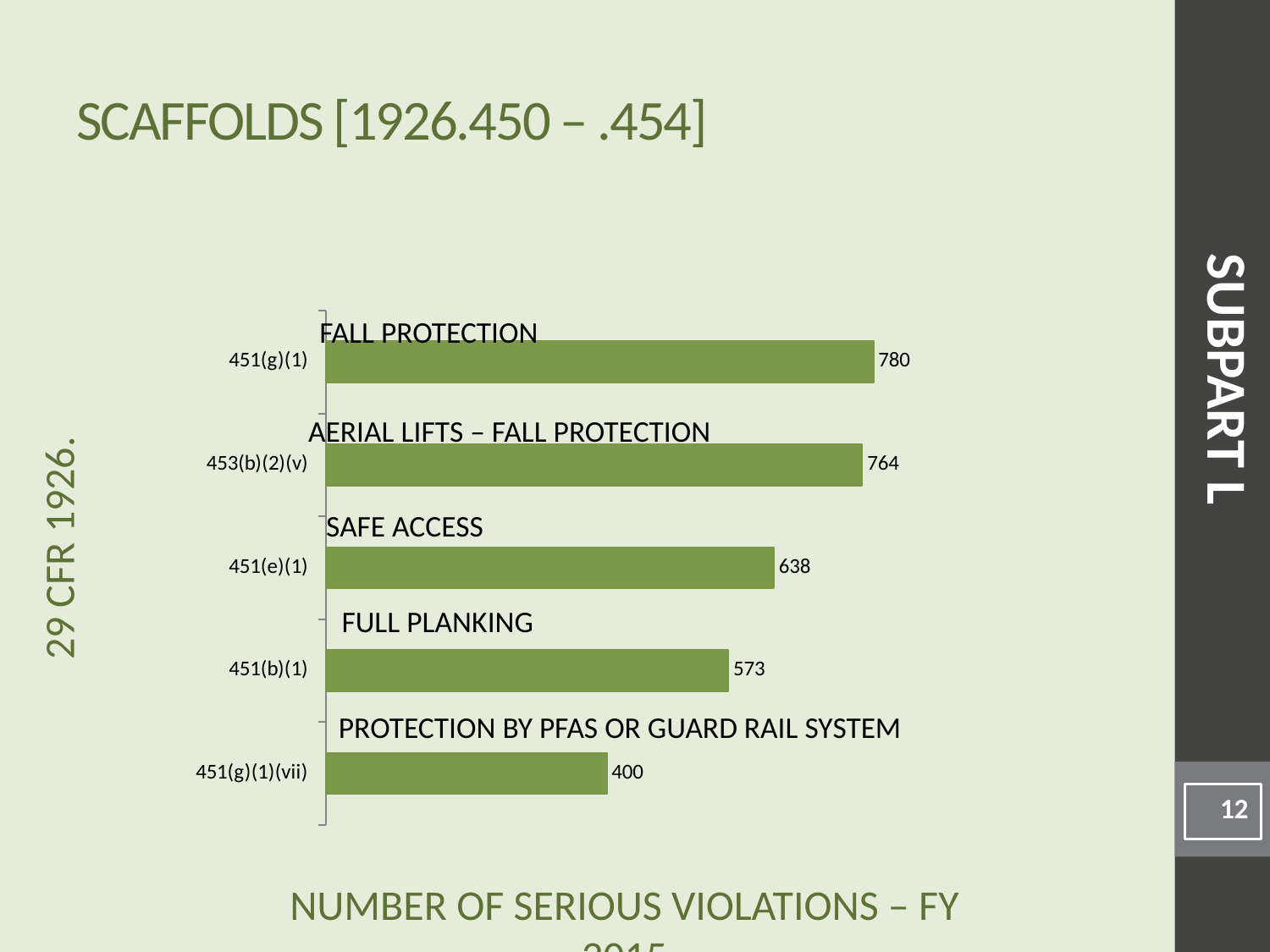
Which category has the highest number of serious violations? 451(g)(1) What is the value shown for 451(e)(1) (Safe Access)? 638 What is the value shown for 451(g)(1)(vii)? 400 What is the difference between the values for 451(g)(1) and 451(g)(1)(vii)? 380 What is the number of serious violations for 451(g)(1)? 780 What is the number of serious violations for 453(b)(2)(v)? 764 Which is larger, the value for 451(e)(1) or the value for 451(b)(1)? 451(e)(1) What is the difference between the values for 451(e)(1) and 451(b)(1)? 65 What is the value shown for 451(b)(1) (Full Planking)? 573 Which category has the lowest number of serious violations? 451(g)(1)(vii) How many categories are shown in the chart? 5 What kind of chart is shown on the slide? Bar chart